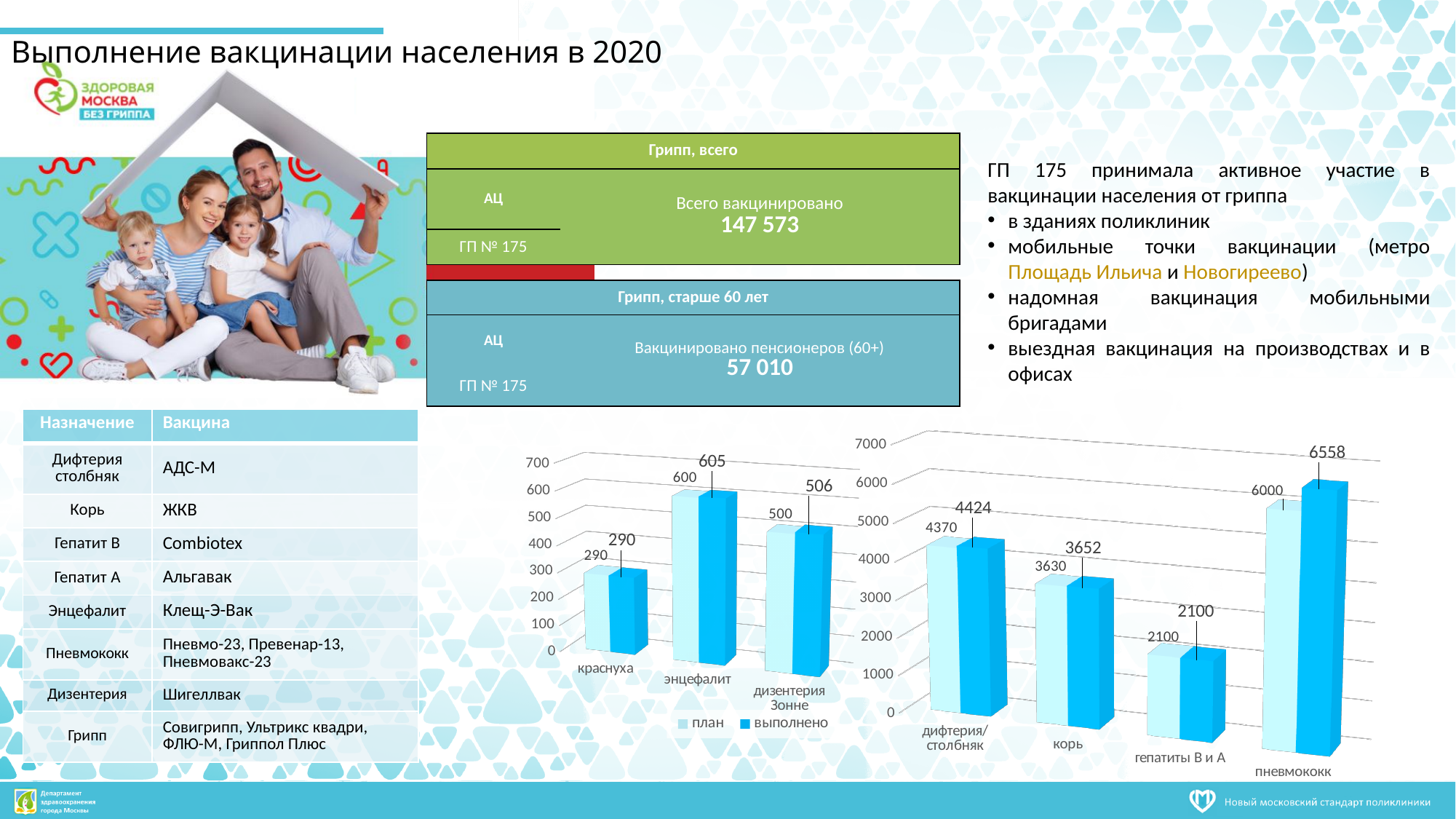
In the left chart, what is the 'план' value for дизентерия Зонне? 500 How many categories are shown in the right chart? 4 In the right chart, what is the 'выполнено' value for пневмококк? 6558 In the left chart, which category has the lowest 'план' value? краснуха In the right chart, what is the difference between 'выполнено' and 'план' for дифтерия/столбняк? 54 In the right chart, what is the difference between 'выполнено' and 'план' for пневмококк? 558 What type of chart is the left chart? bar chart How many series does the legend of the left chart list? 2 In the right chart, which category has the highest 'выполнено' value? пневмококк In the left chart, what is the 'выполнено' value for энцефалит? 605 In the right chart, is the 'план' value for корь larger than the 'план' value for гепатиты В и А? Yes In the right chart, what is the 'план' value for корь? 3630